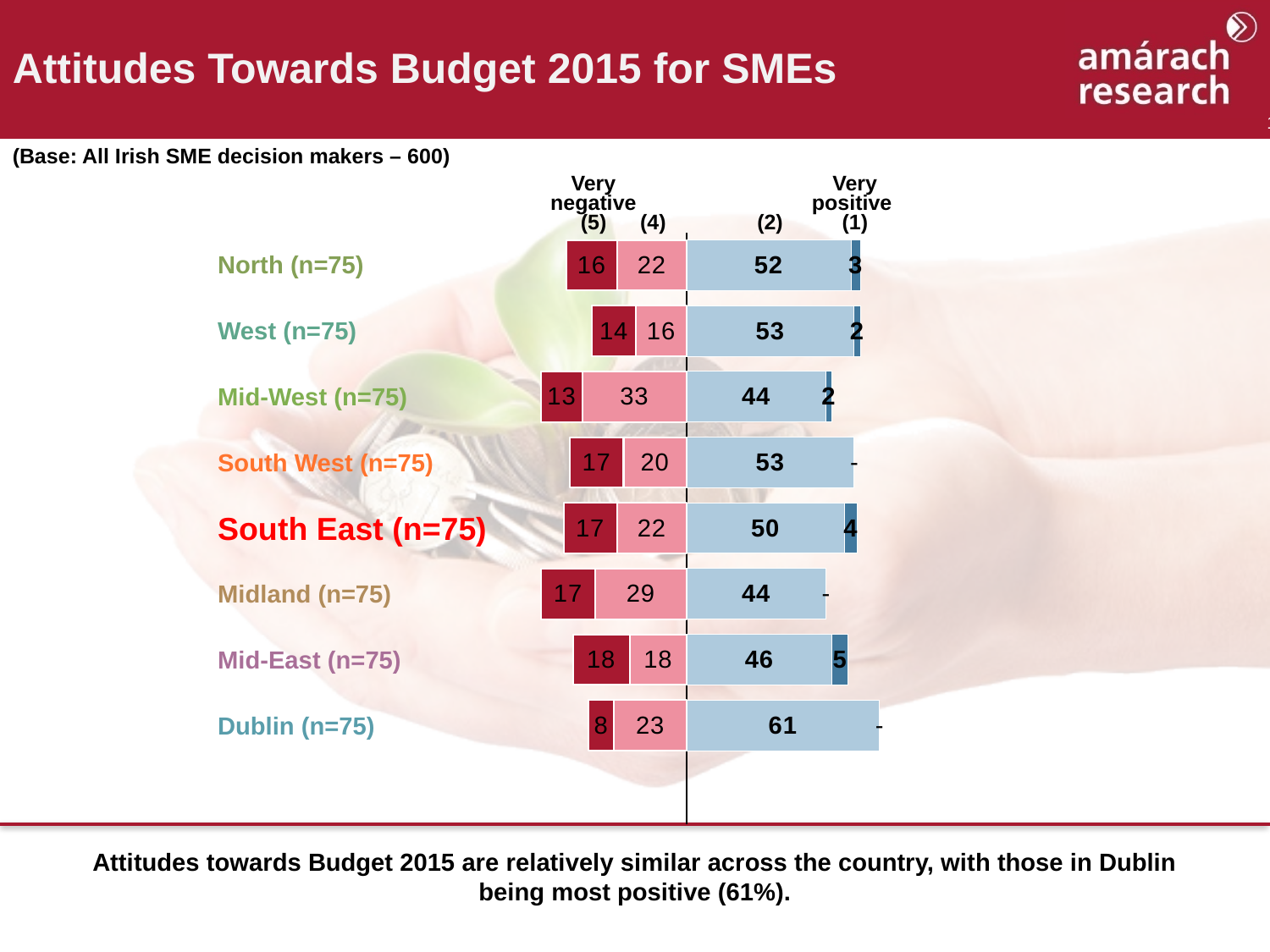
What is the total of the (5) and (4) values for Midland (n=75)? 46 Which region has the lowest value for the (5) Very negative category? Dublin (n=75) What type of chart is shown on the slide? Bar chart What is the value for the (2) category for Dublin (n=75)? 61 Which is larger: the (4) value for Mid-West (n=75) or the (4) value for West (n=75)? Mid-West (n=75) How many regions are shown in the chart? 8 Which region has the highest value for the (2) category? Dublin (n=75) What is the value for the (4) category for Mid-West (n=75)? 33 What is the difference between the (2) values for Dublin (n=75) and Midland (n=75)? 17 How many rating categories (series) are shown in the chart? 4 What is the value for the (5) Very negative category for Mid-East (n=75)? 18 What is the value for the (1) Very positive category for South East (n=75)? 4